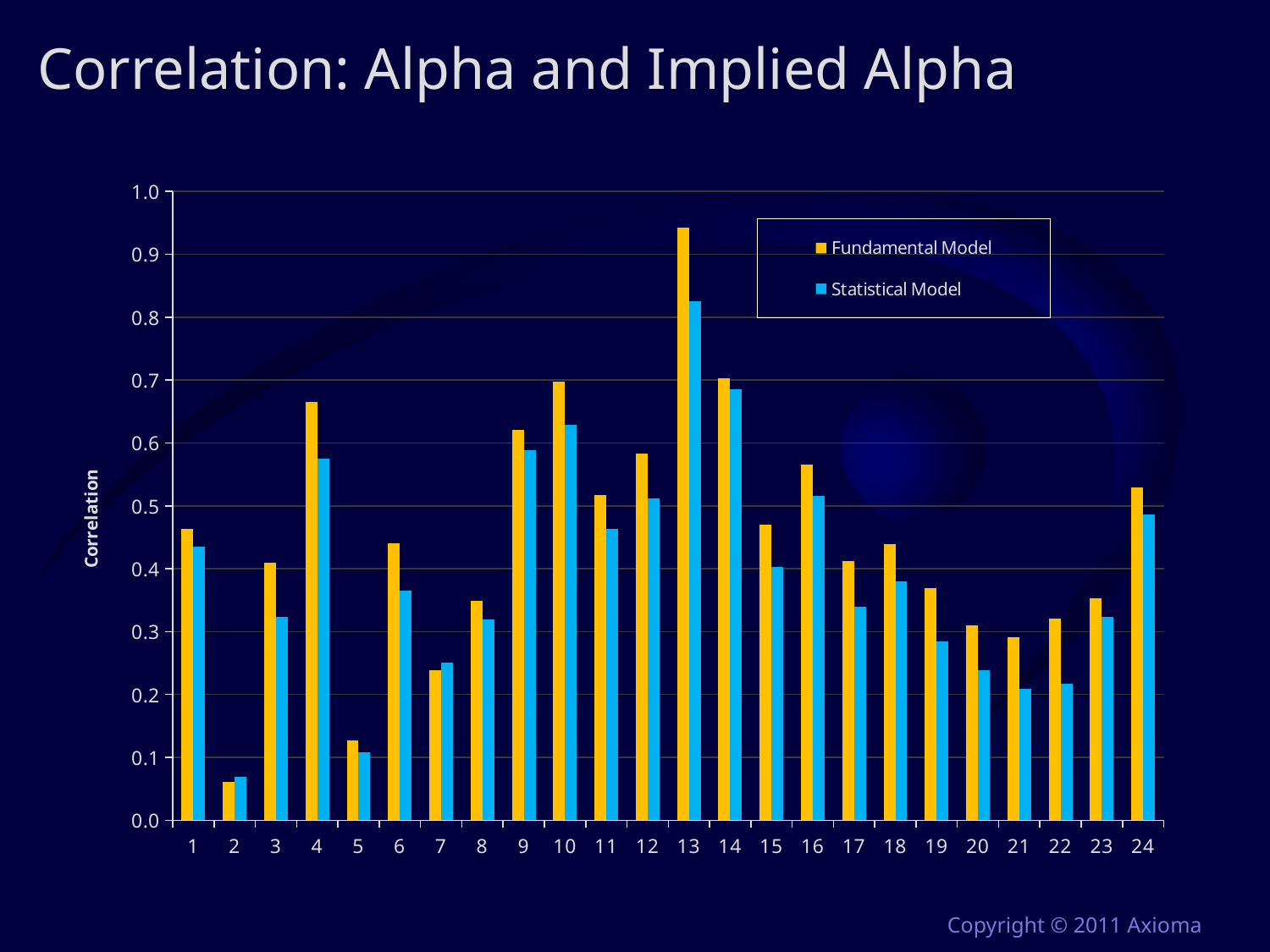
Is the Fundamental Model value for category 4 greater or less than 0.6? greater What type of chart is shown on the slide? bar chart How many categories are shown on the x axis? 24 Is the Fundamental Model value for category 13 greater or less than 0.9? greater How many series does the legend list? 2 For category 3, which series has the larger value, Fundamental Model or Statistical Model? Fundamental Model Which category has the lowest Fundamental Model correlation? 2 Which category has the highest Fundamental Model correlation? 13 Which category has the lowest Statistical Model correlation? 2 Which is larger: the Fundamental Model value for category 10 or the Fundamental Model value for category 12? category 10 What is the label of the vertical axis? Correlation Is the Statistical Model value for category 5 greater or less than 0.2? less